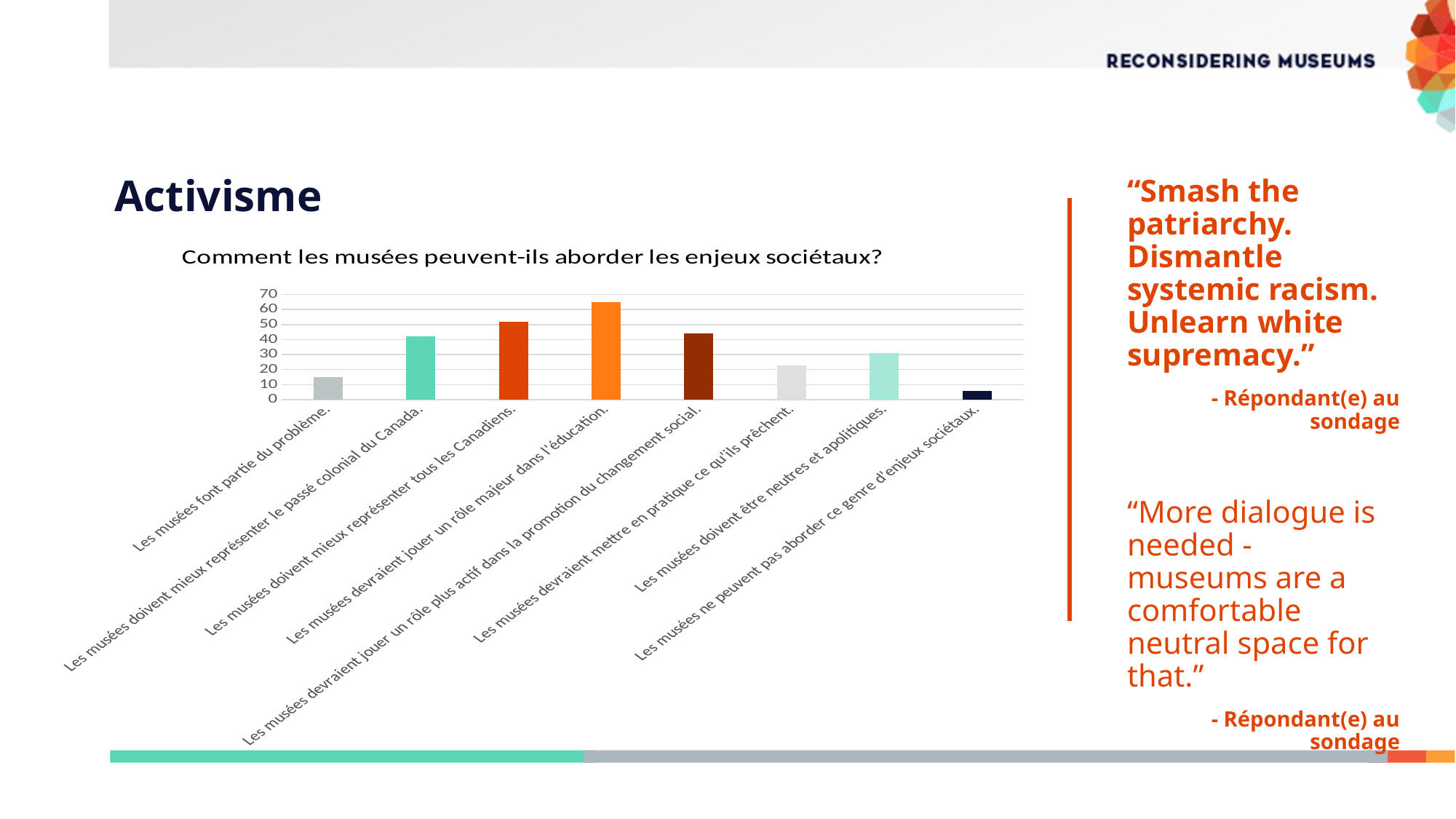
Which category has the highest value? Les musées devraient jouer un rôle majeur dans l'éducation. What kind of chart is shown on the slide? Bar chart Which is larger: the value for "Les musées doivent être neutres et apolitiques." or the value for "Les musées devraient mettre en pratique ce qu'ils prêchent."? Les musées doivent être neutres et apolitiques. Is the value for "Les musées ne peuvent pas aborder ce genre d'enjeux sociétaux." greater or less than 10? less Which is larger: the value for "Les musées doivent mieux représenter le passé colonial du Canada." or the value for "Les musées font partie du problème."? Les musées doivent mieux représenter le passé colonial du Canada. How many categories are plotted in the chart? 8 Is the value for "Les musées devraient jouer un rôle majeur dans l'éducation." greater or less than 60? greater Which category has the lowest value? Les musées ne peuvent pas aborder ce genre d'enjeux sociétaux. Is the value for "Les musées font partie du problème." greater or less than 20? less What is the title of the chart? Comment les musées peuvent-ils aborder les enjeux sociétaux?